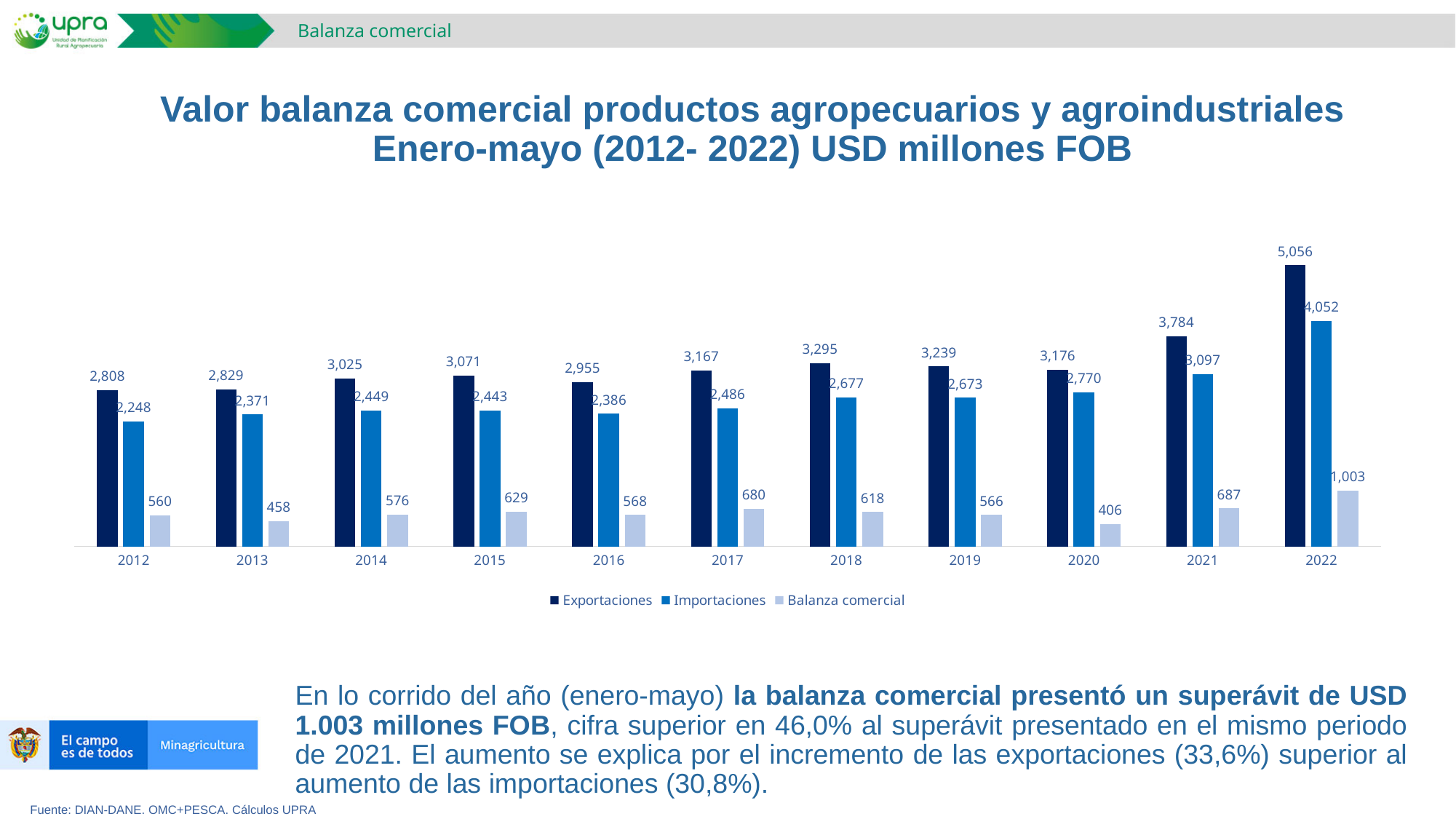
How many years are shown on the x axis? 11 What is the value of Balanza comercial for 2015? 629 Which is larger: Balanza comercial in 2017 or Balanza comercial in 2018? 2017 What is the value of Exportaciones for 2022? 5,056 In which year is Importaciones lowest? 2012 How many series does the legend list? 3 In which year is Balanza comercial lowest? 2020 What is the value of Importaciones for 2018? 2,677 What is the difference between Balanza comercial in 2021 and Balanza comercial in 2020? 281 In which year is Exportaciones highest? 2022 What is the difference between Exportaciones in 2022 and Exportaciones in 2021? 1,272 Do the Importaciones values rise or fall from 2019 to 2022? rise